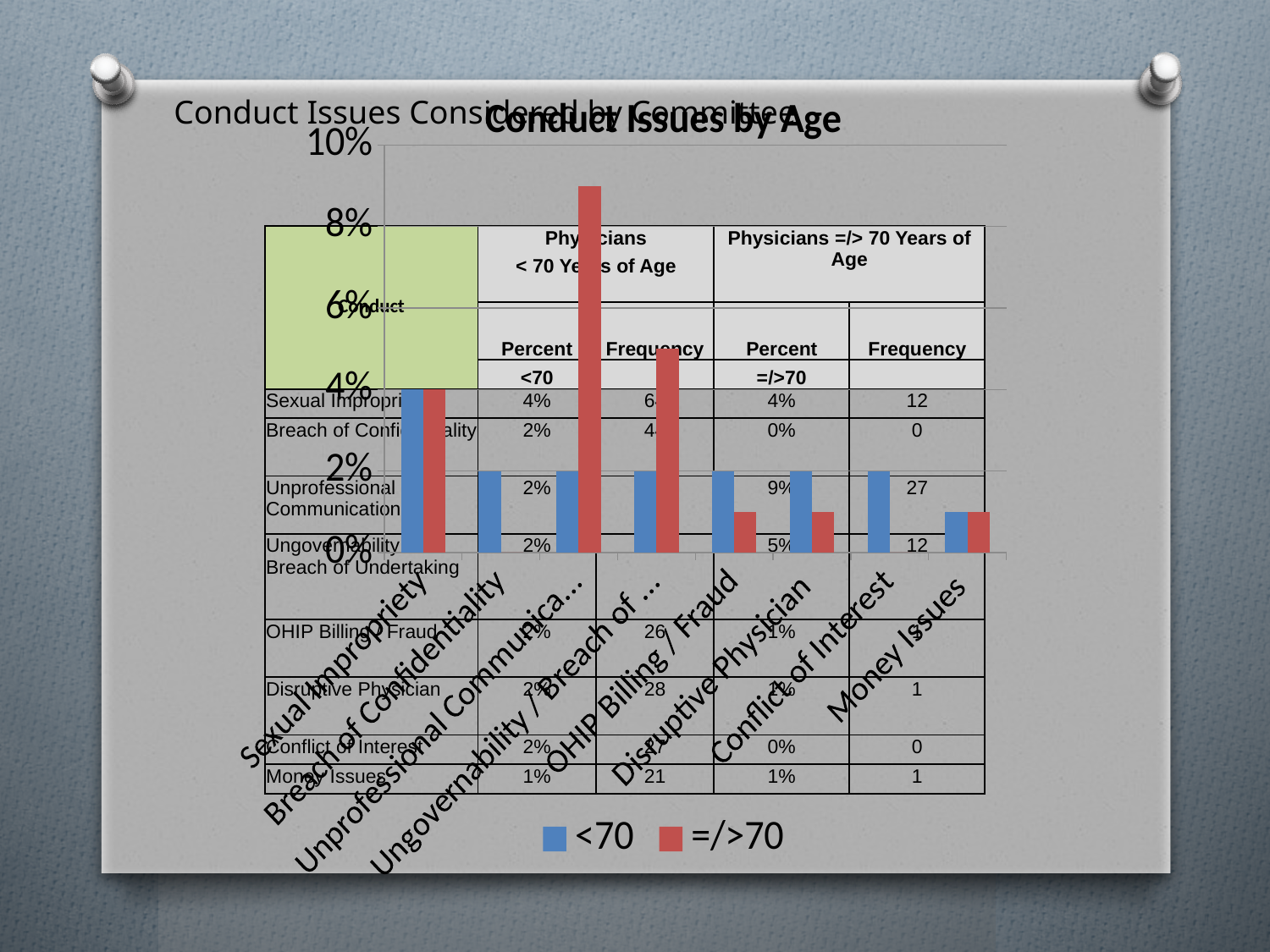
How many conduct issue categories are plotted along the x axis of the chart? 8 Is the =/>70 value for Unprofessional Communication greater or less than 8%? greater What is the <70 value for Sexual Impropriety? 4% What are the two legend entries of the chart? <70 and =/>70 For Breach of Confidentiality, which series has the larger value, <70 or =/>70? <70 What kind of chart is shown on the slide? bar chart Which category has the highest =/>70 bar in the chart? Unprofessional Communication For Ungovernability / Breach of Undertaking, which series has the larger value, <70 or =/>70? =/>70 Is the =/>70 value for Ungovernability / Breach of Undertaking greater or less than 4%? greater What is the =/>70 value for Sexual Impropriety? 4% How many series does the legend of the Conduct Issues by Age chart list? 2 Which category has the lowest <70 bar in the chart? Money Issues